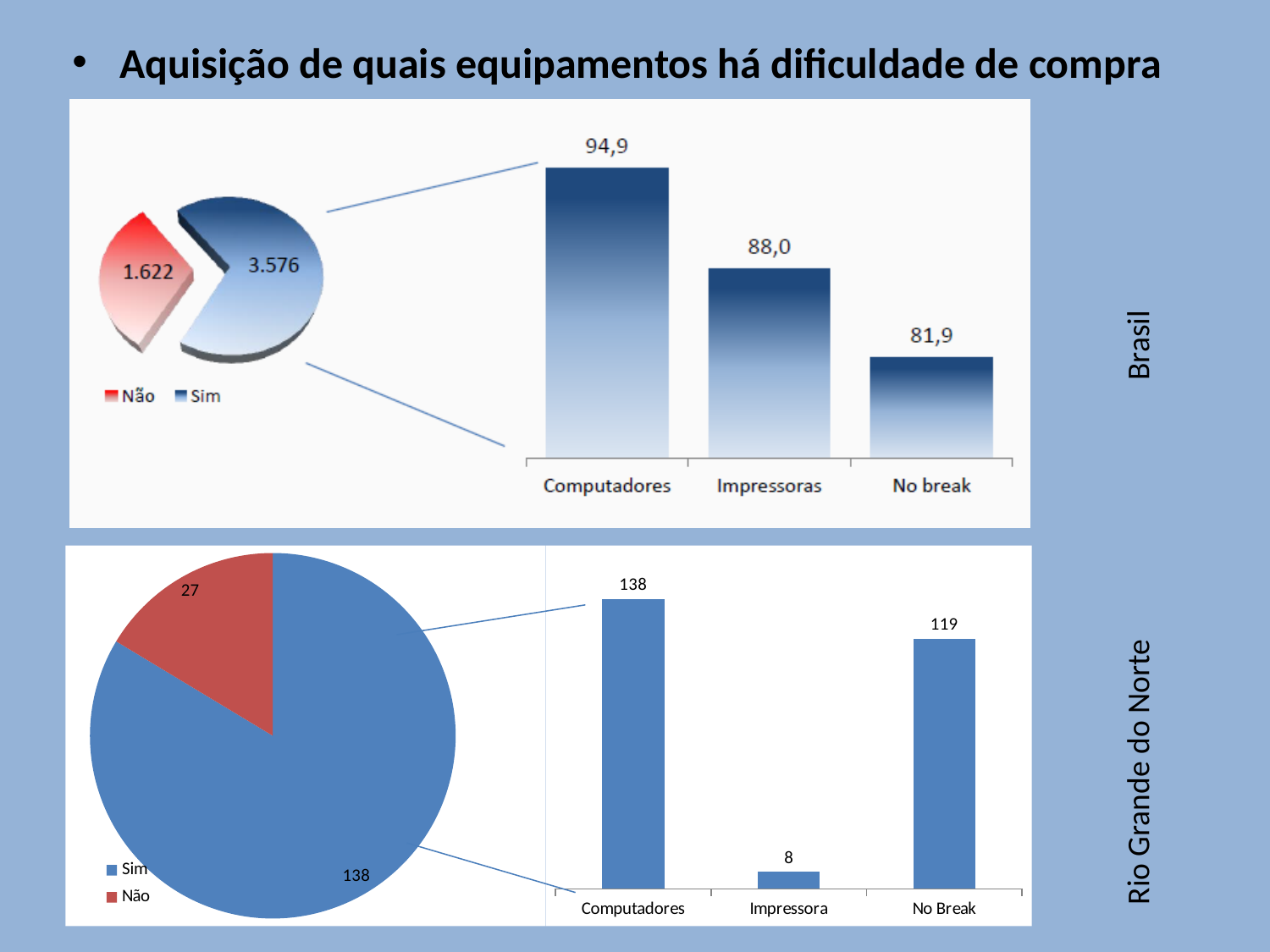
In the Brasil pie chart (top), what is the value of the Sim slice? 3.576 In the Rio Grande do Norte pie chart (bottom), which is larger, Sim or Não? Sim In the Brasil pie chart (top), what is the value of the Não slice? 1.622 How many categories does the Rio Grande do Norte bar chart (bottom) show? 3 In the Rio Grande do Norte bar chart (bottom), what is the value for Impressora? 8 What kind of chart shows the Computadores, Impressoras and No break values in the Brasil panel (top)? Bar chart In the Rio Grande do Norte pie chart (bottom), what is the value of the Não slice? 27 In the Brasil bar chart (top), what is the value for Computadores? 94,9 In the Rio Grande do Norte bar chart (bottom), what is the difference between Computadores and No Break? 19 In the Brasil bar chart (top), which category has the lowest value? No break In the Brasil bar chart (top), what is the value for No break? 81,9 In the Rio Grande do Norte bar chart (bottom), which category has the highest value? Computadores